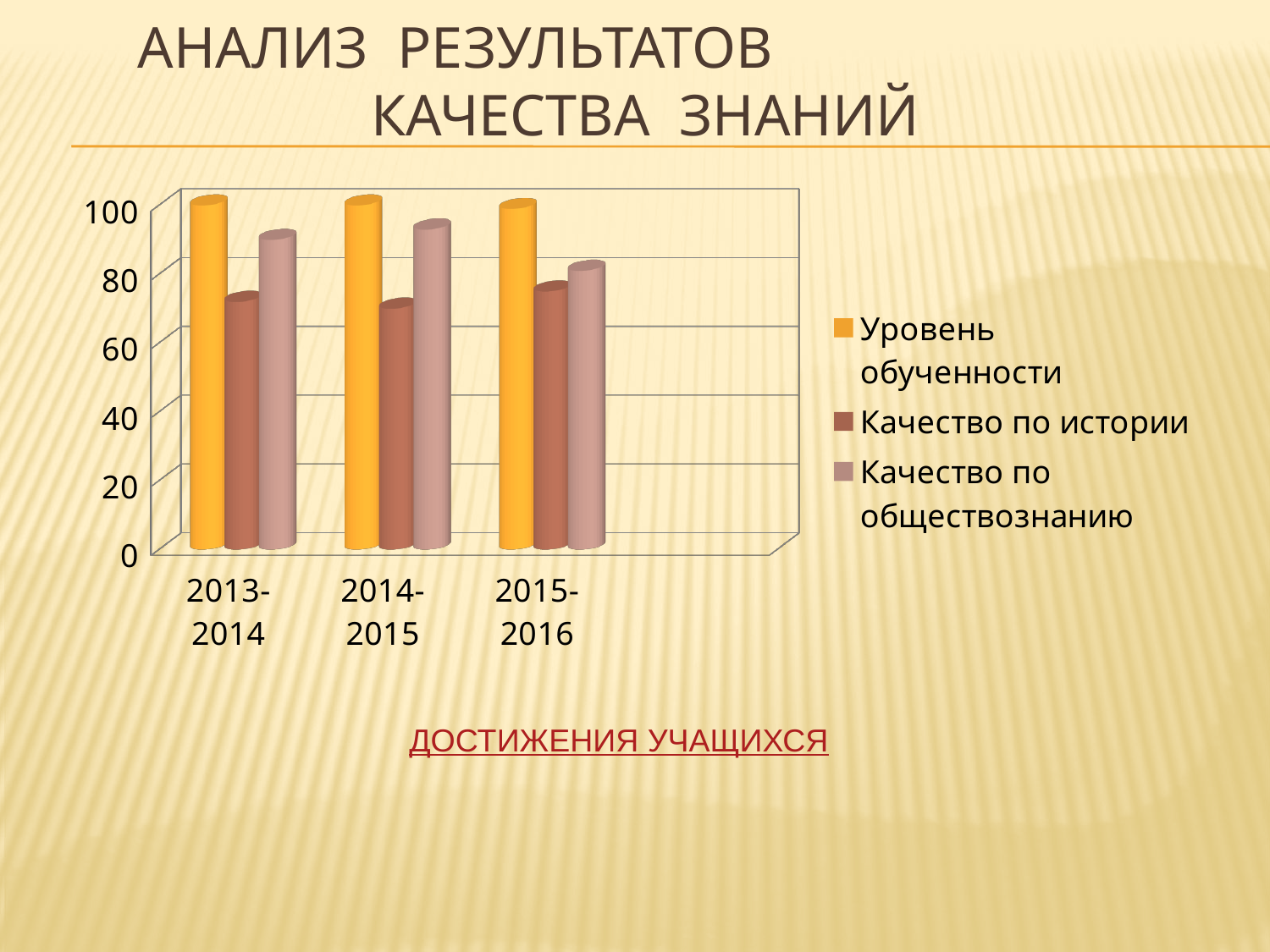
Is the value for Качество по обществознанию in 2014-2015 greater or less than 80? greater What kind of chart is shown on the slide? bar chart In which academic year is Качество по обществознанию lowest? 2015-2016 Is the value for Качество по истории in 2013-2014 greater or less than 80? less How many academic years are shown on the x axis? 3 In 2015-2016, which is larger: Уровень обученности or Качество по истории? Уровень обученности In 2013-2014, which is larger: Качество по истории or Качество по обществознанию? Качество по обществознанию How many series does the legend list? 3 Which series is shown in yellow-orange bars? Уровень обученности Is the value for Уровень обученности in 2015-2016 greater or less than 80? greater What is the first entry listed in the legend? Уровень обученности